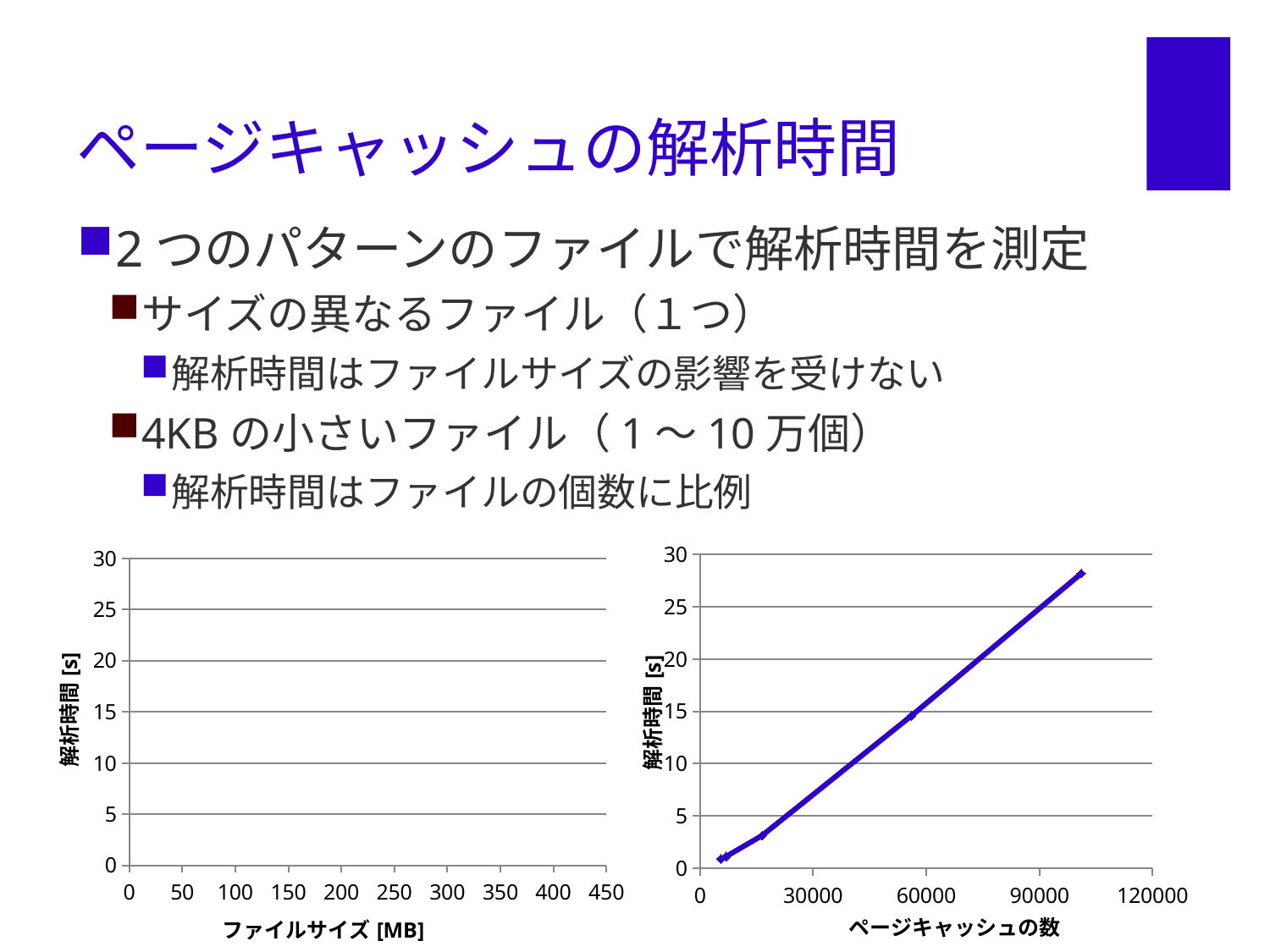
What is the x-axis title of the left-hand chart? ファイルサイズ [MB] In the right-hand chart, is the 解析時間 at around 90000 page caches greater or less than 20? greater What kind of chart is the right-hand chart (ページキャッシュの数 on the x axis)? line chart In the right-hand chart, is the 解析時間 at around 60000 page caches greater or less than 10? greater In the right-hand chart, is the 解析時間 at the smallest ページキャッシュの数 plotted greater or less than 5? less What is the x-axis title of the right-hand chart? ページキャッシュの数 In the right-hand chart, does the 解析時間 rise or fall as ページキャッシュの数 increases? rise In the right-hand chart, what is the maximum value shown on the y axis? 30